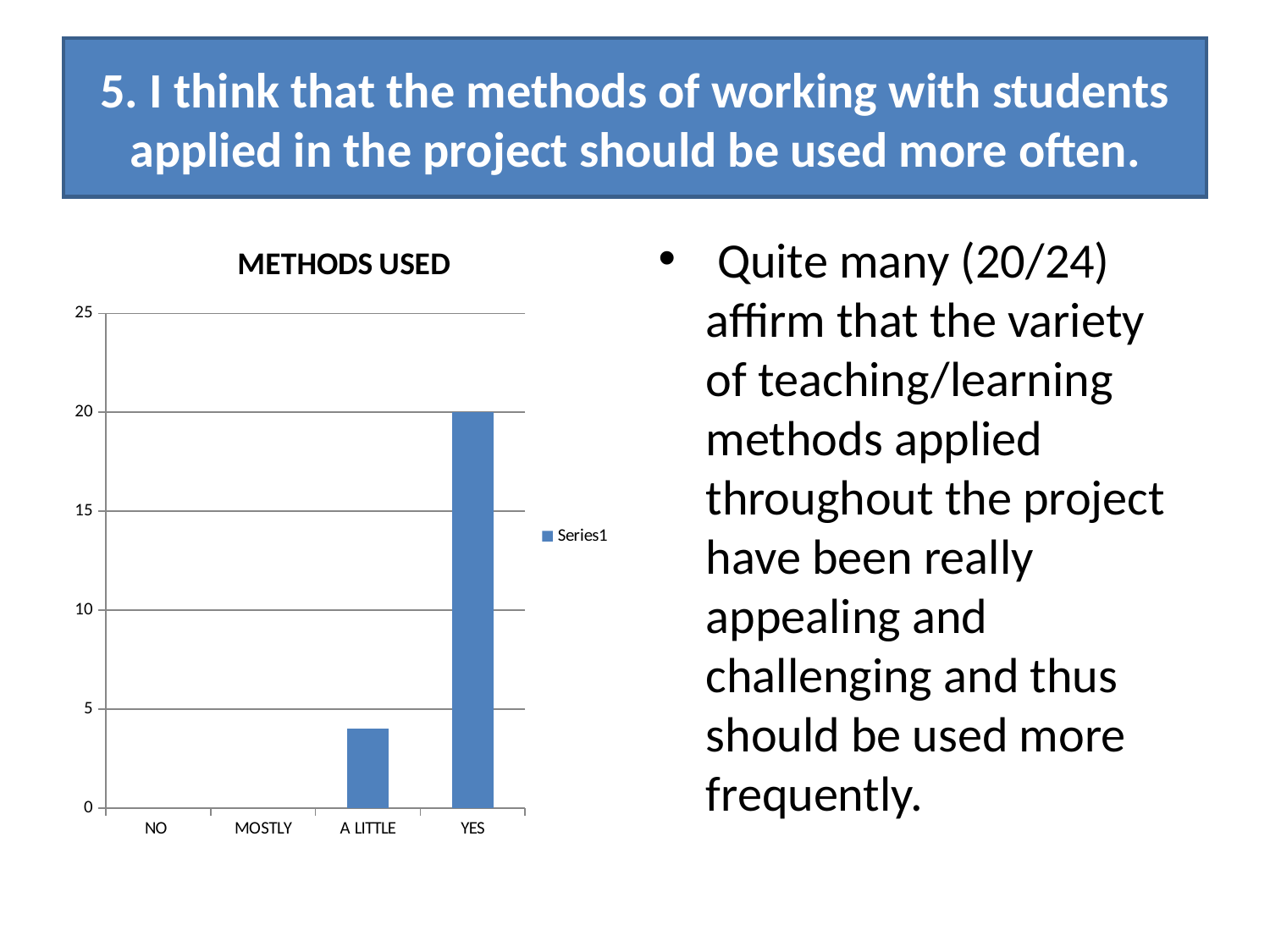
Is the value for YES greater or less than 15? greater What is the title of the chart on the slide? METHODS USED Which is larger, the value for A LITTLE or the value for MOSTLY? A LITTLE What kind of chart is shown on the slide? bar chart How many series does the legend of the METHODS USED chart list? 1 What is the value for YES in the METHODS USED chart? 20 Which category has the highest value in the METHODS USED chart? YES Is the value for A LITTLE greater or less than 5? less What is the highest value shown on the vertical axis of the METHODS USED chart? 25 What is the name of the series listed in the chart legend? Series1 How many categories are shown on the x axis of the METHODS USED chart? 4 Which is larger, the value for YES or the value for A LITTLE? YES